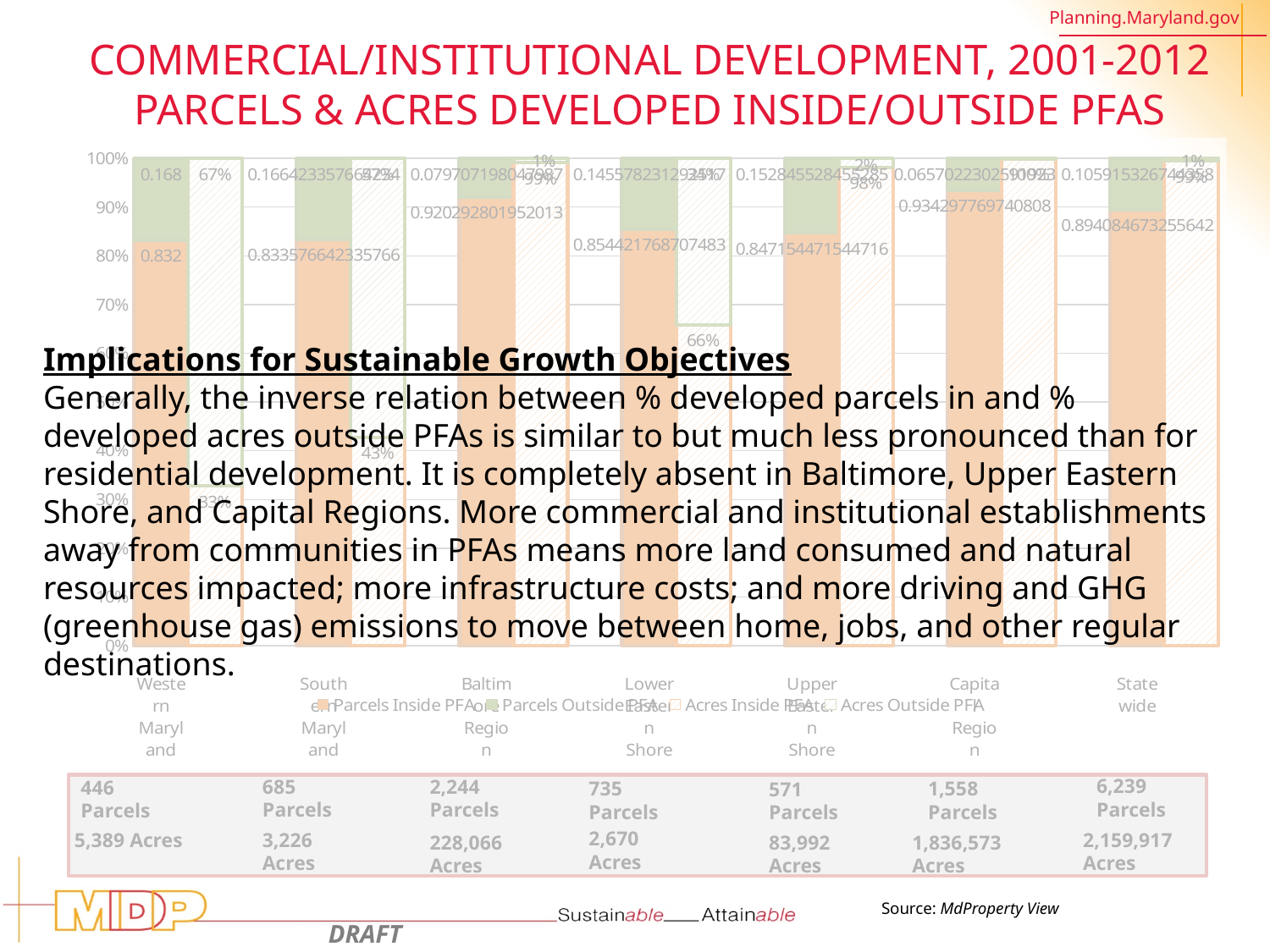
What is the Parcels Inside PFA value for the Capital Region? 0.934297769740808 How many series does the chart legend list? 4 Which region has the highest Parcels Inside PFA value? Capital Region What is the Parcels Inside PFA value for Western Maryland? 0.832 What are the four legend entries of the chart? Parcels Inside PFA, Parcels Outside PFA, Acres Inside PFA, Acres Outside PFA What is the Parcels Outside PFA value for Western Maryland? 0.168 What kind of chart is shown on the slide? Stacked bar chart What is the Statewide Parcels Inside PFA value? 0.894084673255642 How many regions (categories) are shown along the x axis of the chart? 7 What is the Parcels Inside PFA value for the Baltimore Region? 0.920292801952013 What is the difference between the Parcels Inside PFA and Parcels Outside PFA values for Western Maryland? 0.664 Which has the larger Parcels Inside PFA value, the Baltimore Region or the Lower Eastern Shore? Baltimore Region